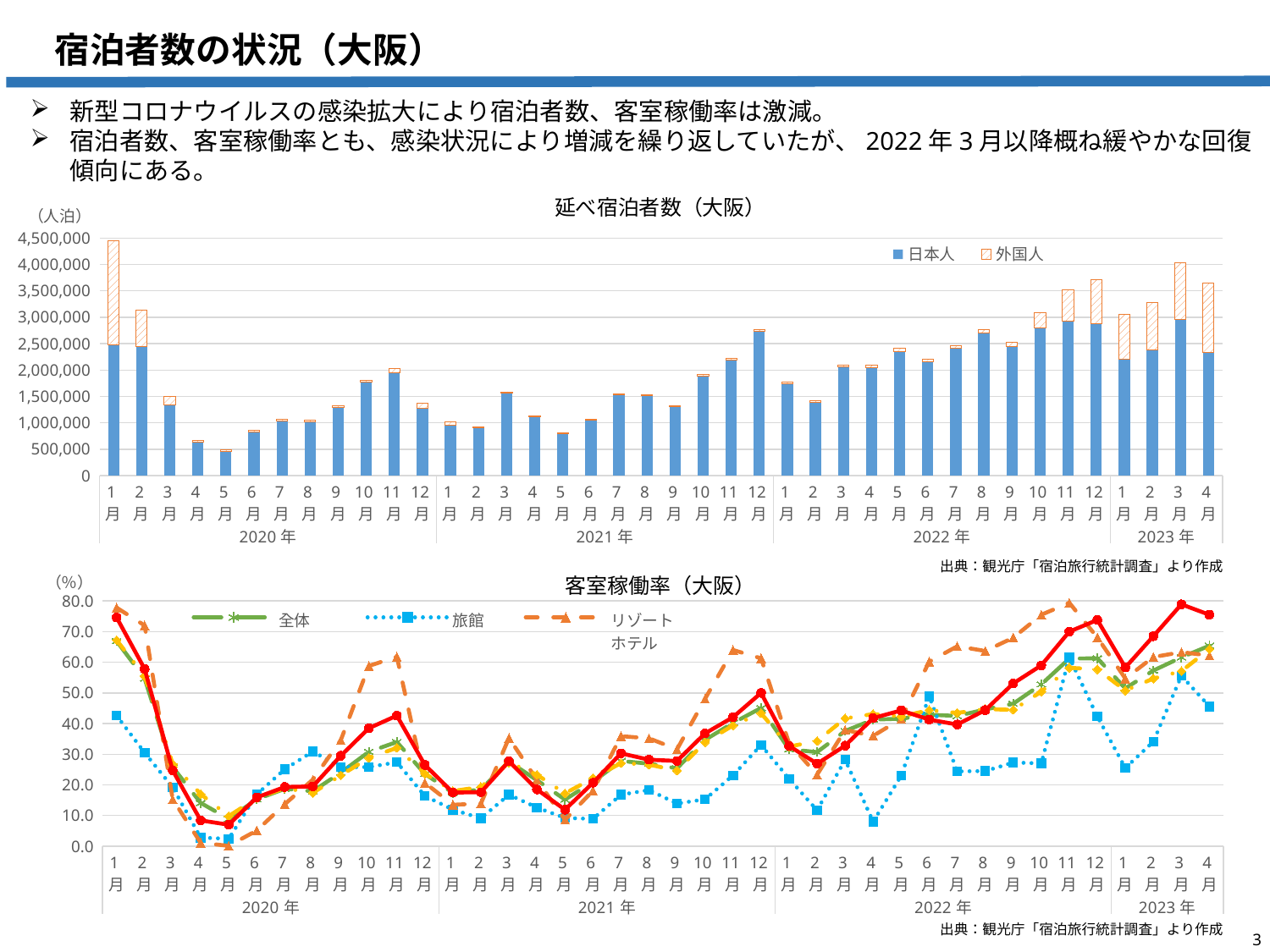
In the top chart 延べ宿泊者数（大阪）, which month has the lowest total number of guest nights? 2020年5月 In the top chart 延べ宿泊者数（大阪）, is the 日本人 value for 2021年12月 greater or less than 2,500,000? greater What kind of chart is the bottom chart titled 客室稼働率（大阪）? line chart In the bottom chart 客室稼働率（大阪）, is the 全体 value for 2020年1月 greater or less than 60.0? greater In the top chart 延べ宿泊者数（大阪）, is the total value for 2020年1月 greater or less than 4,000,000? greater What kind of chart is the top chart titled 延べ宿泊者数（大阪）? bar chart In the bottom chart 客室稼働率（大阪）, which is larger in 2020年1月, 全体 or 旅館? 全体 In the top chart 延べ宿泊者数（大阪）, which month has the highest total number of guest nights? 2020年1月 In the top chart 延べ宿泊者数（大阪）, how many series does the legend list? 2 In the top chart 延べ宿泊者数（大阪）, how many months are plotted along the x axis? 40